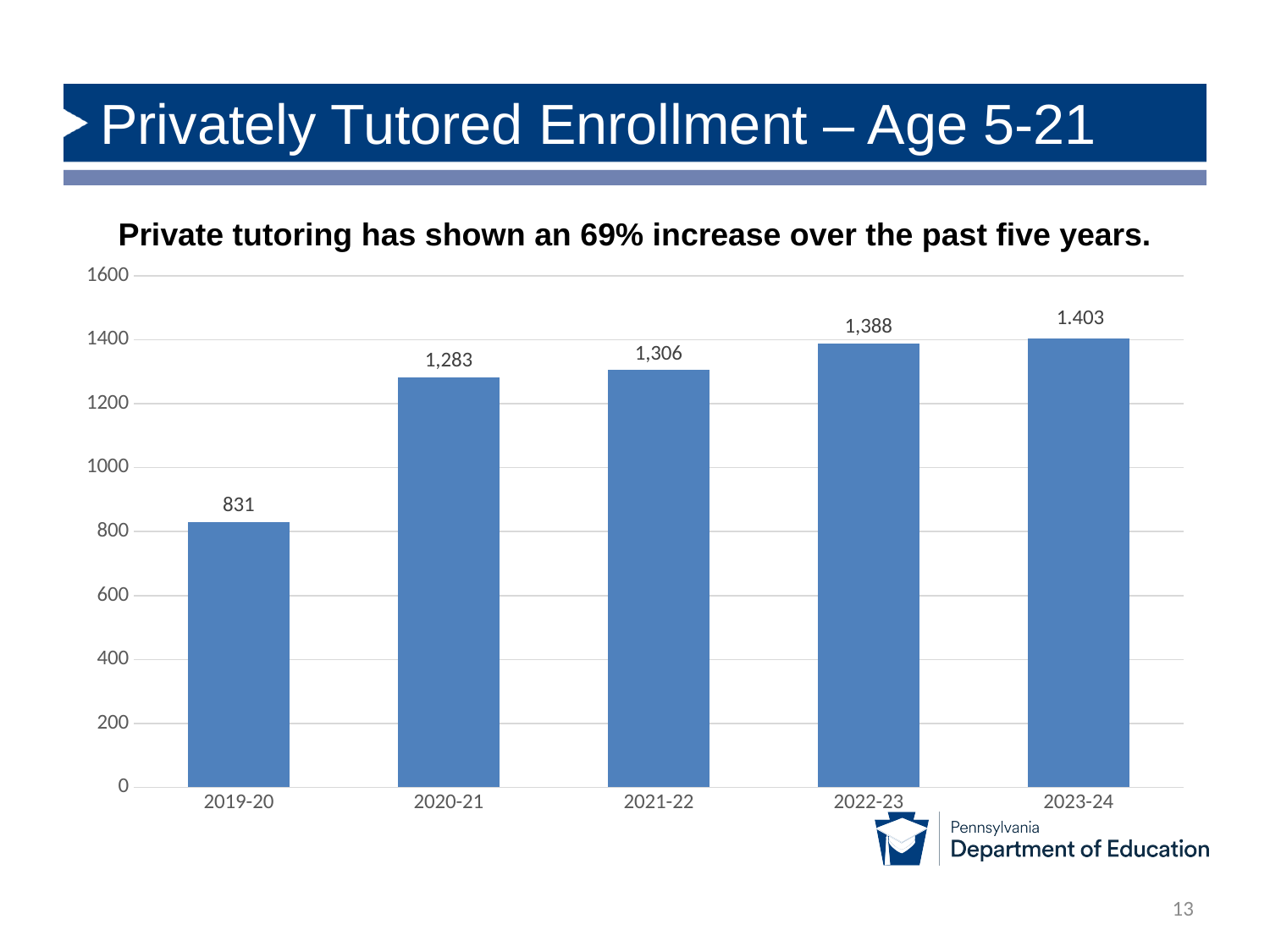
What is the privately tutored enrollment for 2021-22? 1,306 Is the enrollment for 2019-20 greater or less than 1000? less What is the difference in enrollment between 2022-23 and 2021-22? 82 What is the privately tutored enrollment for 2020-21? 1,283 Which is larger, the enrollment for 2021-22 or for 2020-21? 2021-22 Which school year has the lowest privately tutored enrollment? 2019-20 What is the privately tutored enrollment for 2022-23? 1,388 How many school years are shown on the chart? 5 What kind of chart is shown on the slide? bar chart Which school year has the highest privately tutored enrollment? 2023-24 What is the privately tutored enrollment for 2019-20? 831 What is the difference in enrollment between 2020-21 and 2019-20? 452